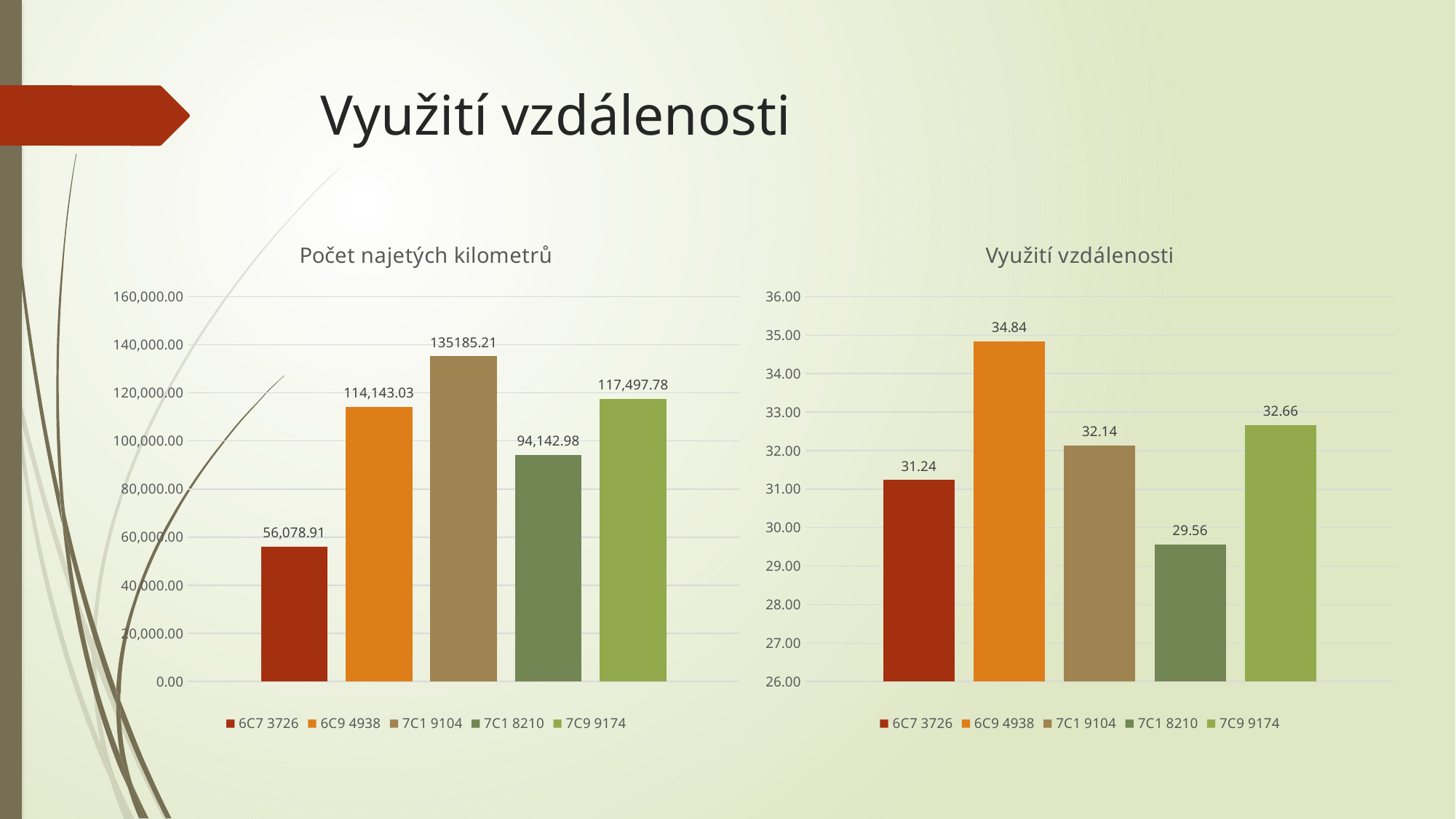
In the chart titled "Využití vzdálenosti", what is the value for 7C1 8210? 29.56 In the chart titled "Počet najetých kilometrů", which vehicle has the lowest value? 6C7 3726 In the chart titled "Počet najetých kilometrů", what is the value for 7C1 9104? 135185.21 In the chart titled "Počet najetých kilometrů", what is the difference between the values for 7C1 9104 and 6C7 3726? 79,106.30 What kind of chart is the chart titled "Počet najetých kilometrů"? bar chart In the chart titled "Využití vzdálenosti", what is the difference between the highest and lowest values? 5.28 How many series does the legend of the chart titled "Využití vzdálenosti" list? 5 In the chart titled "Počet najetých kilometrů", what is the value for 6C7 3726? 56,078.91 What is the title of the chart on the left side of the slide? Počet najetých kilometrů In the chart titled "Využití vzdálenosti", which vehicle has the highest value? 6C9 4938 In the chart titled "Počet najetých kilometrů", which is larger: the value for 6C9 4938 or 7C9 9174? 7C9 9174 In the chart titled "Využití vzdálenosti", is the value for 6C7 3726 greater or less than 32.00? less